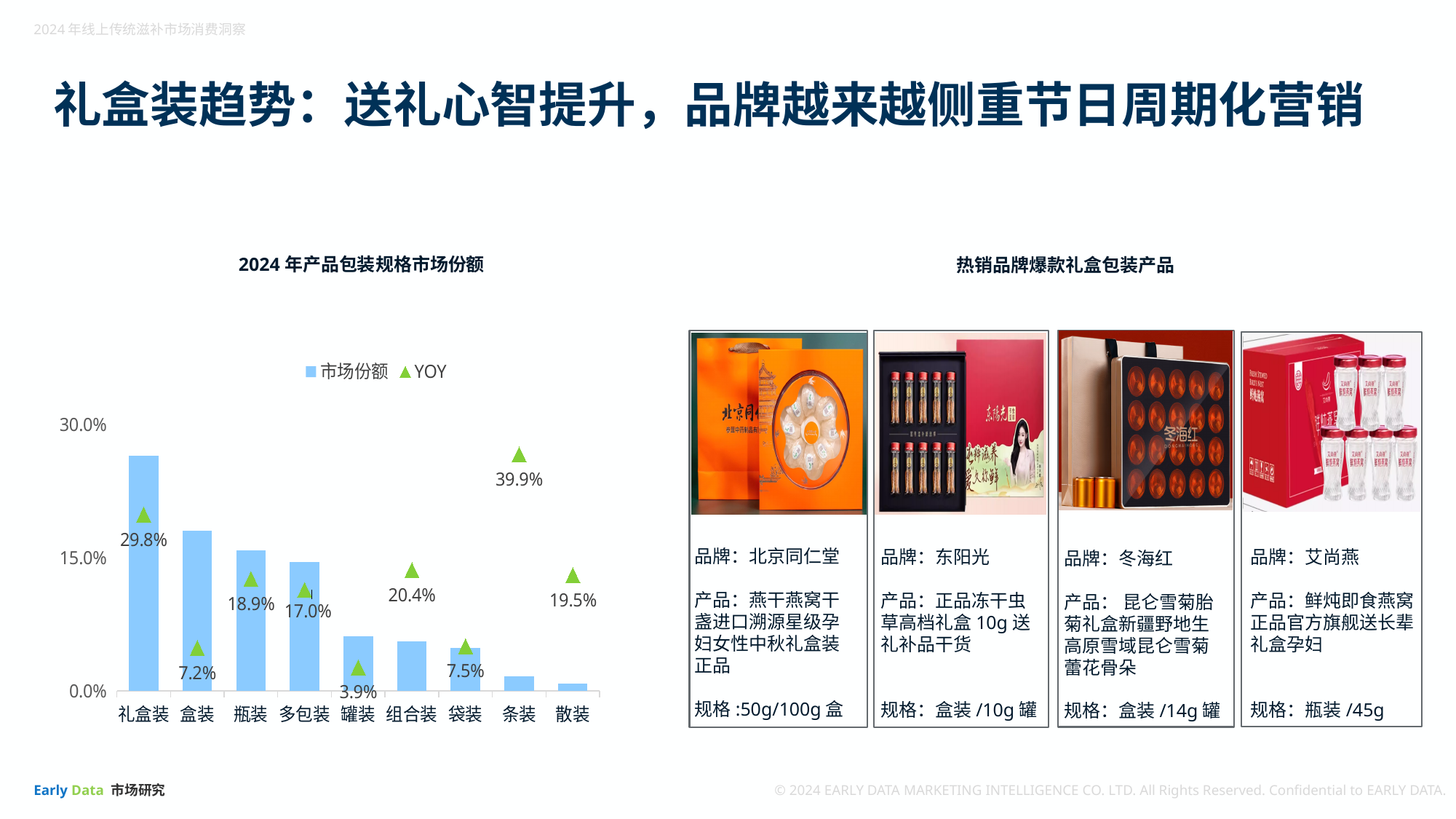
Do the 市场份额 bars rise or fall from left to right in the chart 2024 年产品包装规格市场份额? fall Is the 市场份额 value for 罐装 greater or less than 15.0% in the chart 2024 年产品包装规格市场份额? less Which has the larger YOY value in the chart 2024 年产品包装规格市场份额, 瓶装 or 多包装? 瓶装 Which category has the lowest YOY value in the chart 2024 年产品包装规格市场份额? 罐装 How many series does the legend of the chart 2024 年产品包装规格市场份额 list? 2 What is the difference between the YOY values for 礼盒装 and 盒装 in the chart 2024 年产品包装规格市场份额? 22.6% Which category has the highest YOY value in the chart 2024 年产品包装规格市场份额? 条装 Is the 市场份额 value for 礼盒装 greater or less than 15.0% in the chart 2024 年产品包装规格市场份额? greater How many packaging categories are shown on the x axis of the chart 2024 年产品包装规格市场份额? 9 What is the YOY value for 组合装 in the chart 2024 年产品包装规格市场份额? 20.4% What is the YOY value for 礼盒装 in the chart 2024 年产品包装规格市场份额? 29.8% What is the YOY value for 散装 in the chart 2024 年产品包装规格市场份额? 19.5%